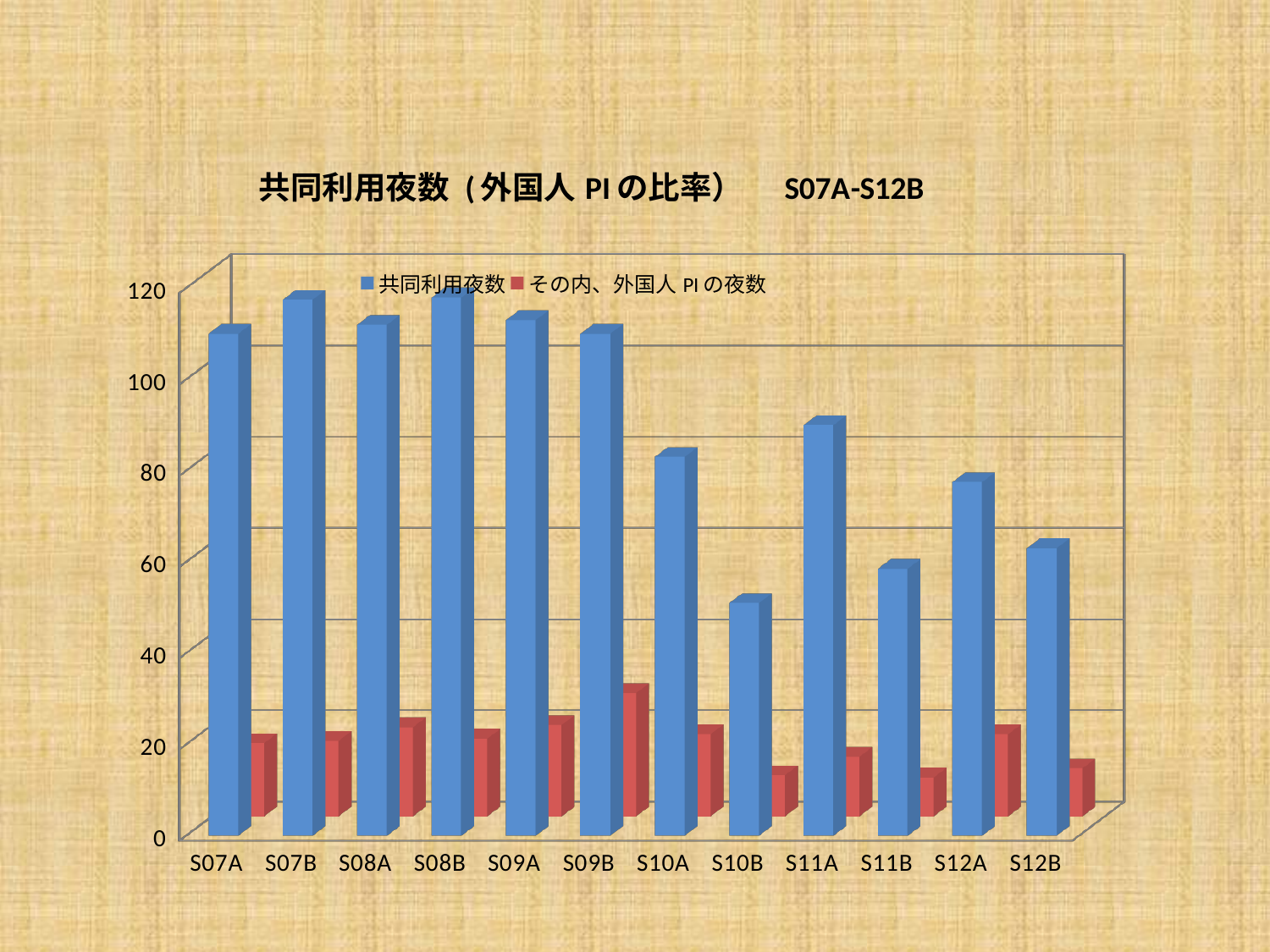
Is the その内、外国人 PI の夜数 value for S09B greater or less than 20? greater What kind of chart is shown on the slide? bar chart Is the 共同利用夜数 value for S10B greater or less than 60? less Is the 共同利用夜数 value for S07A greater or less than 100? greater Which has the larger 共同利用夜数 value, S11A or S10B? S11A How many categories are shown on the x axis of the chart? 12 How many series does the chart's legend list? 2 Which category has the highest value for その内、外国人 PI の夜数? S09B Which series is shown in red in the chart? その内、外国人 PI の夜数 Which category has the lowest value for 共同利用夜数? S10B What is the title of the chart? 共同利用夜数（外国人 PI の比率） S07A-S12B Overall, do the 共同利用夜数 values rise or fall from S07A to S12B? fall